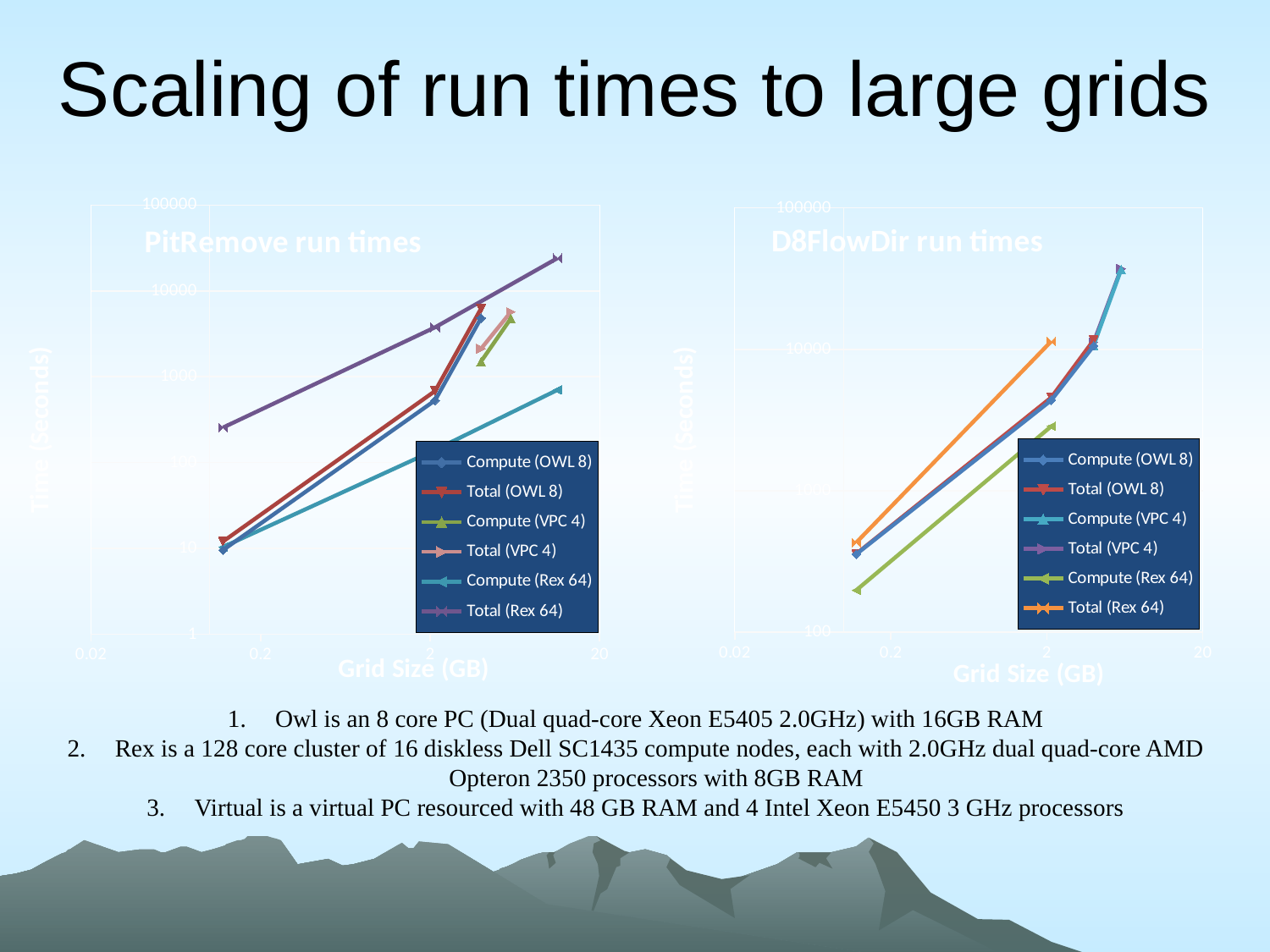
How many series does the legend of the D8FlowDir run times chart list? 6 In the D8FlowDir run times chart, is the value for Compute (Rex 64) at the smallest grid size greater or less than 1000? less What is the title of the chart on the left of the slide? PitRemove run times In the D8FlowDir run times chart, is the value for Compute (VPC 4) at the largest grid size greater or less than 10000? greater In the D8FlowDir run times chart, do run times rise or fall as grid size increases? Rise In the PitRemove run times chart, is the value for Compute (Rex 64) at the largest grid size greater or less than 1000? less In the PitRemove run times chart, at the smallest grid size, which is larger: Total (Rex 64) or Compute (OWL 8)? Total (Rex 64) In the PitRemove run times chart, do run times rise or fall as grid size increases? Rise What is the x-axis label of the D8FlowDir run times chart? Grid Size (GB) In the D8FlowDir run times chart, at the smallest grid size, which is larger: Total (Rex 64) or Compute (Rex 64)? Total (Rex 64) What kind of chart is the PitRemove run times chart? Line chart